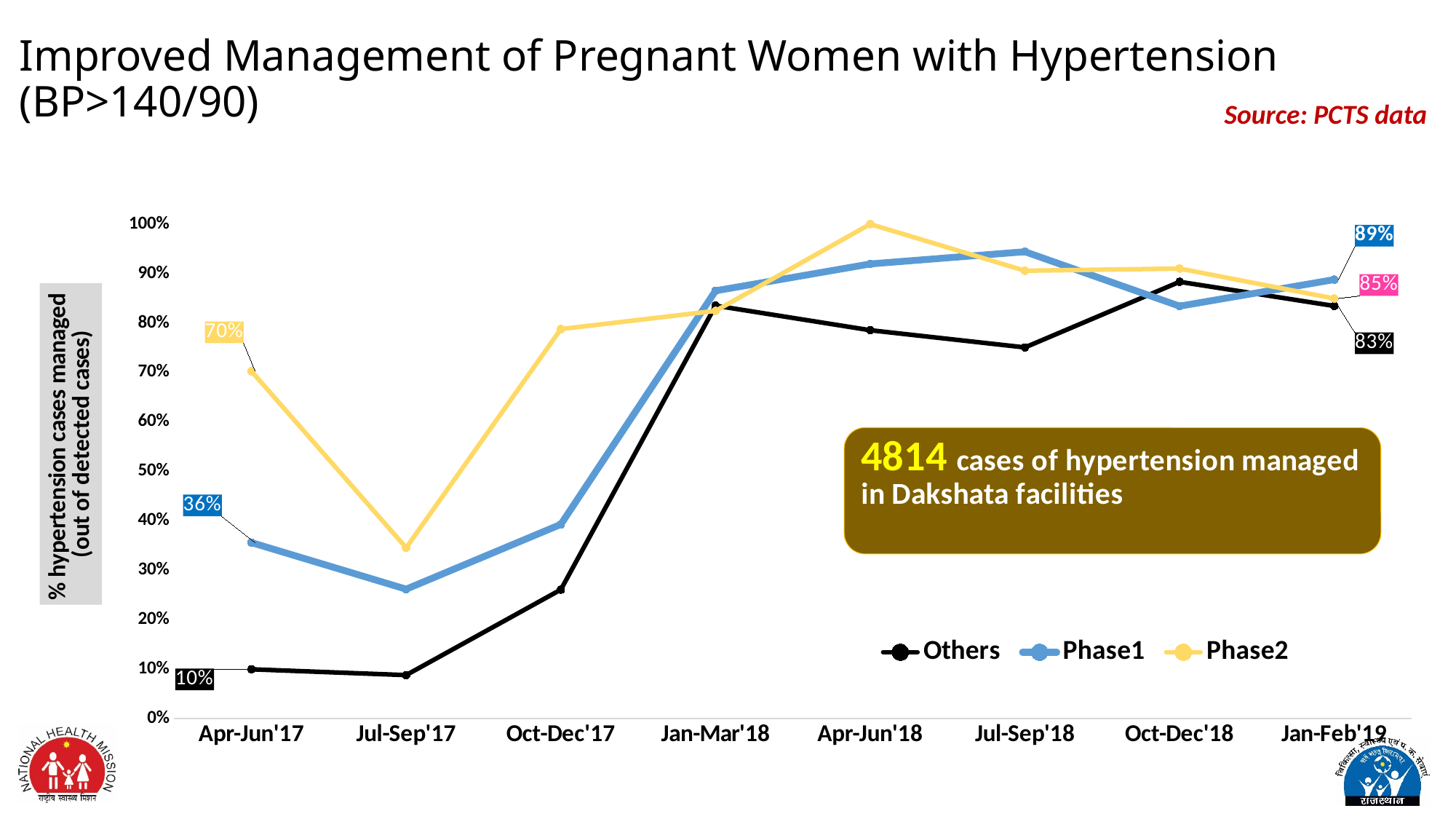
Is the value for Phase2 in Apr-Jun'18 greater or less than 90%? greater What is the difference between Phase2 and Others in Apr-Jun'17? 60 percentage points How many time periods are shown on the x axis? 8 In Apr-Jun'17, which is larger: Phase1 or Others? Phase1 What is the value for Phase2 in Apr-Jun'17? 70% What is the value for Others in Jan-Feb'19? 83% How many series does the legend list? 3 What kind of chart is shown on the slide? Line chart What is the value for Others in Apr-Jun'17? 10% What is the value for Phase1 in Jan-Feb'19? 89% Which series has the lowest value in Jan-Feb'19? Others Which series has the highest value in Apr-Jun'17? Phase2